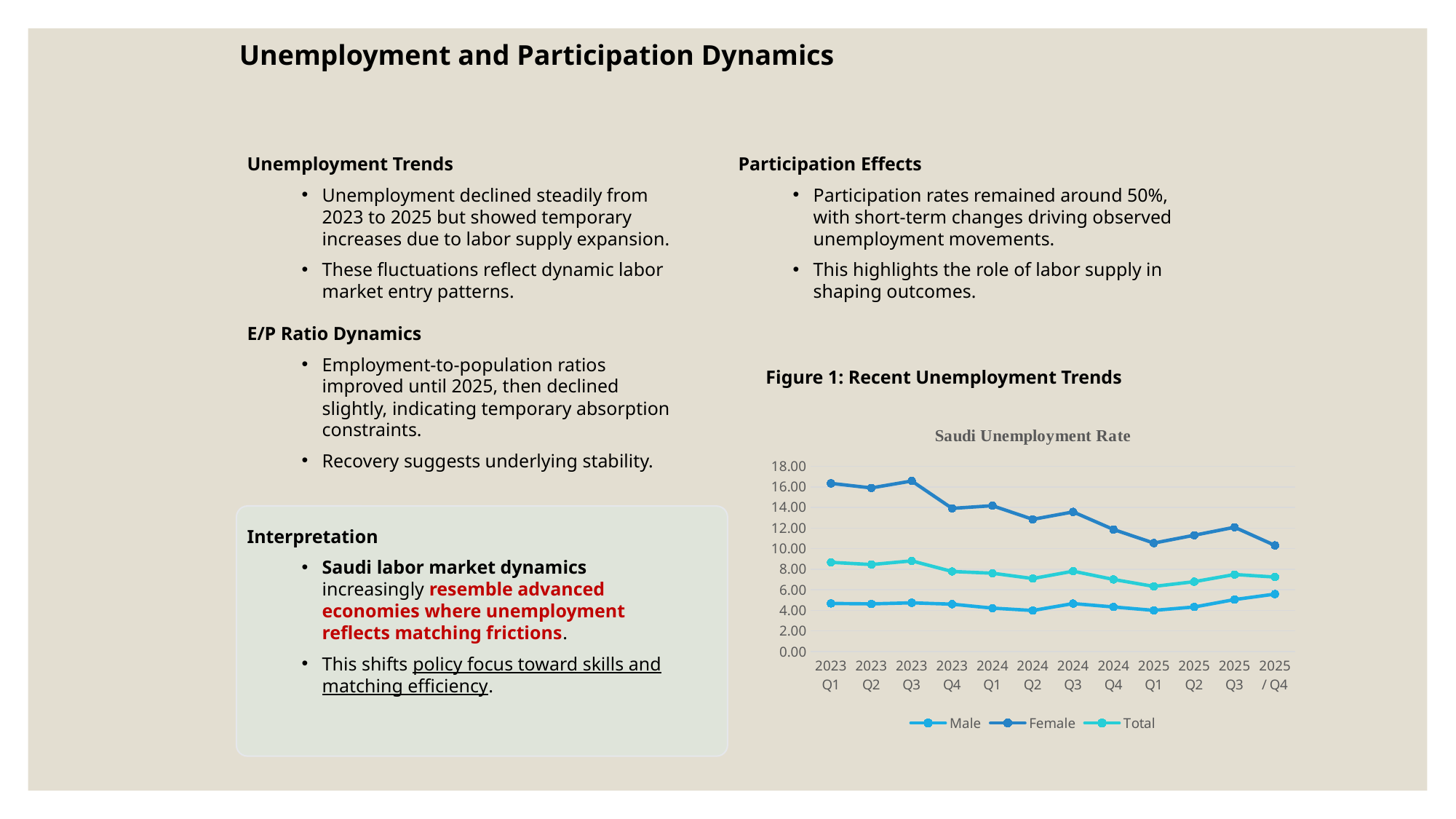
Is the Female unemployment rate in 2023 Q1 greater or less than 14.00? greater What kind of chart is shown in Figure 1 on the slide? Line chart In 2024 Q1, which series has the higher unemployment rate, Male or Female? Female Is the Total unemployment rate in 2025 Q1 greater or less than 8.00? less What is the title of the chart in Figure 1? Saudi Unemployment Rate Which series are listed in the legend of the Saudi Unemployment Rate chart? Male, Female, Total Is the Female unemployment rate in 2025 Q1 greater or less than 12.00? less Does the Female unemployment rate generally rise or fall from 2023 Q1 to 2025 Q4? Fall How many series does the legend of the Saudi Unemployment Rate chart list? 3 In which quarter is the Male unemployment rate highest? 2025 Q4 How many quarters are plotted along the x axis of the Saudi Unemployment Rate chart? 12